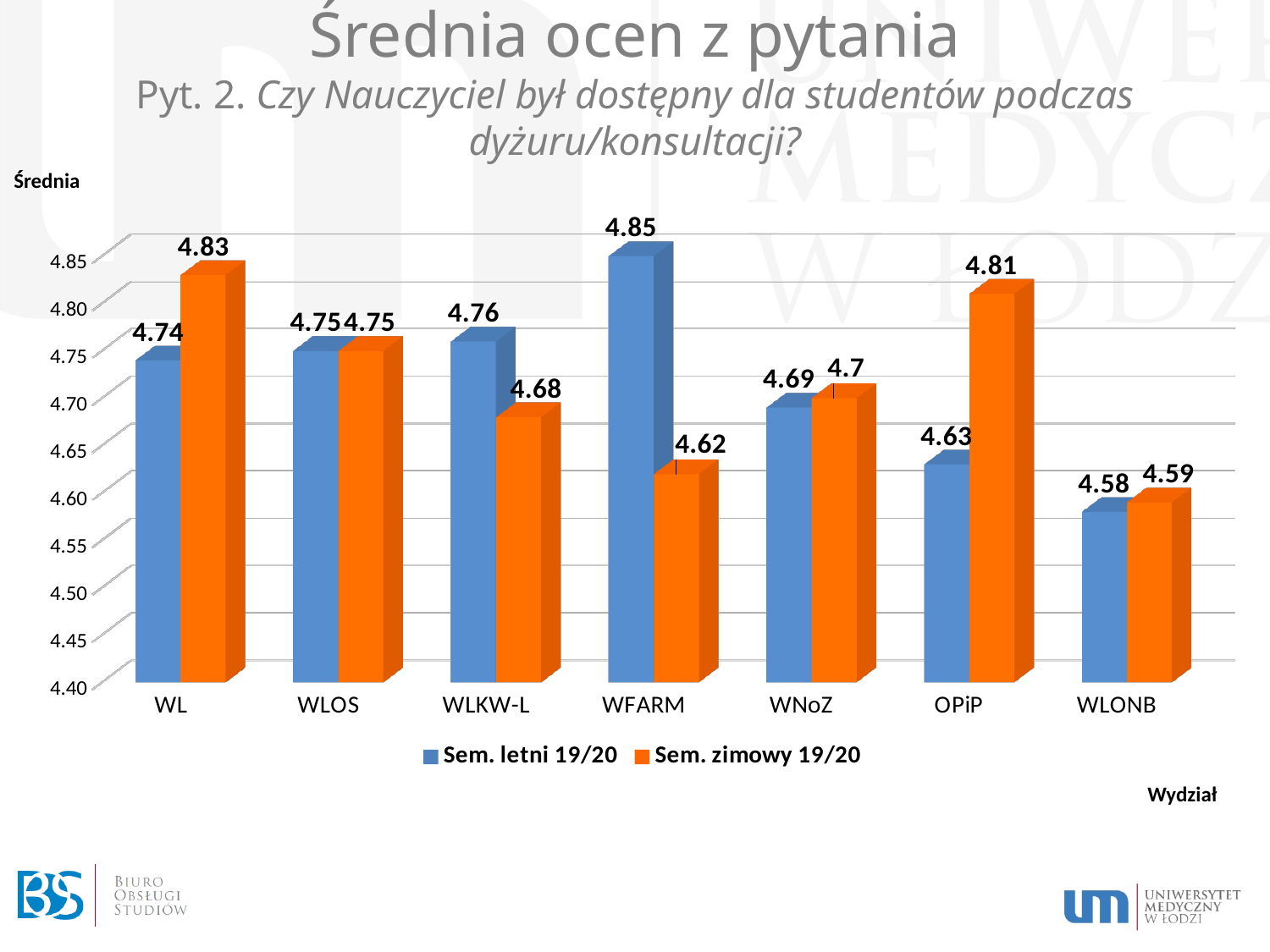
What kind of chart is shown on the slide? bar chart How many series does the legend list? 2 Which category has the lowest value in the Sem. zimowy 19/20 series? WLONB What is the value for OPiP in the Sem. zimowy 19/20 series? 4.81 What is the value for WL in the Sem. letni 19/20 series? 4.74 What is the difference between the Sem. letni 19/20 and Sem. zimowy 19/20 values for WFARM? 0.23 How many categories are shown on the x axis? 7 What is the value for WFARM in the Sem. zimowy 19/20 series? 4.62 Is the Sem. zimowy 19/20 value for WL greater or less than 4.80? greater What colour are the Sem. zimowy 19/20 bars? orange Which category has the highest value in the Sem. letni 19/20 series? WFARM Which is larger for OPiP: the Sem. letni 19/20 value or the Sem. zimowy 19/20 value? Sem. zimowy 19/20